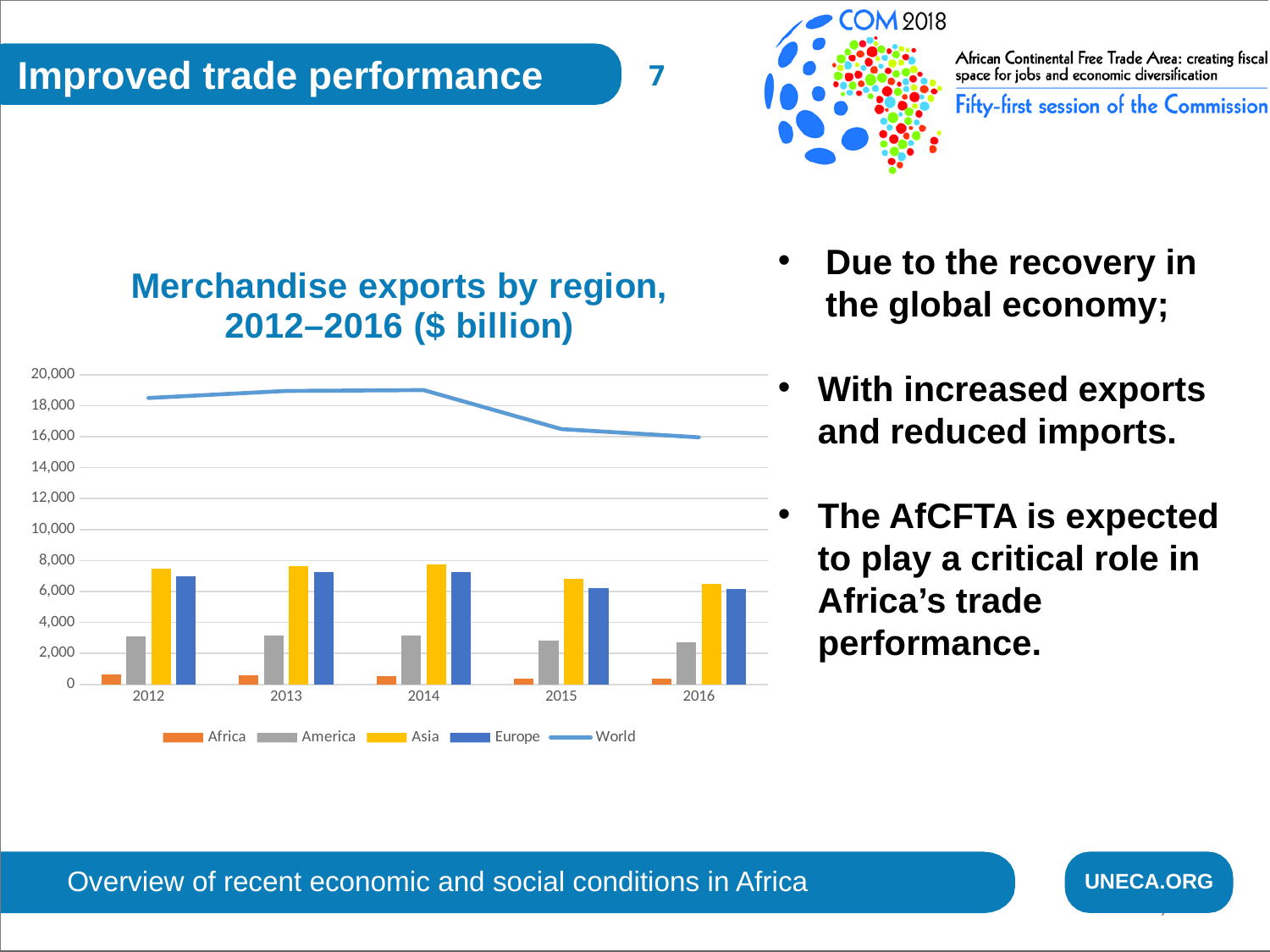
Which series is shown as a line rather than bars? World What kind of chart is used to show the regional series (Africa, America, Asia, Europe)? Bar chart Which region has the lowest merchandise exports in 2016? Africa How many years are shown on the x axis of the chart? 5 How many series does the chart legend list? 5 Is the value for Asia in 2014 greater or less than 6,000? greater Is the value for World in 2012 greater or less than 18,000? greater Which is larger in 2012, the value for Asia or the value for Europe? Asia What is the title of the chart? Merchandise exports by region, 2012–2016 ($ billion) Which region has the highest merchandise exports in 2014? Asia Does the World series rise or fall between 2014 and 2016? Fall Is the value for America in 2012 greater or less than 2,000? greater